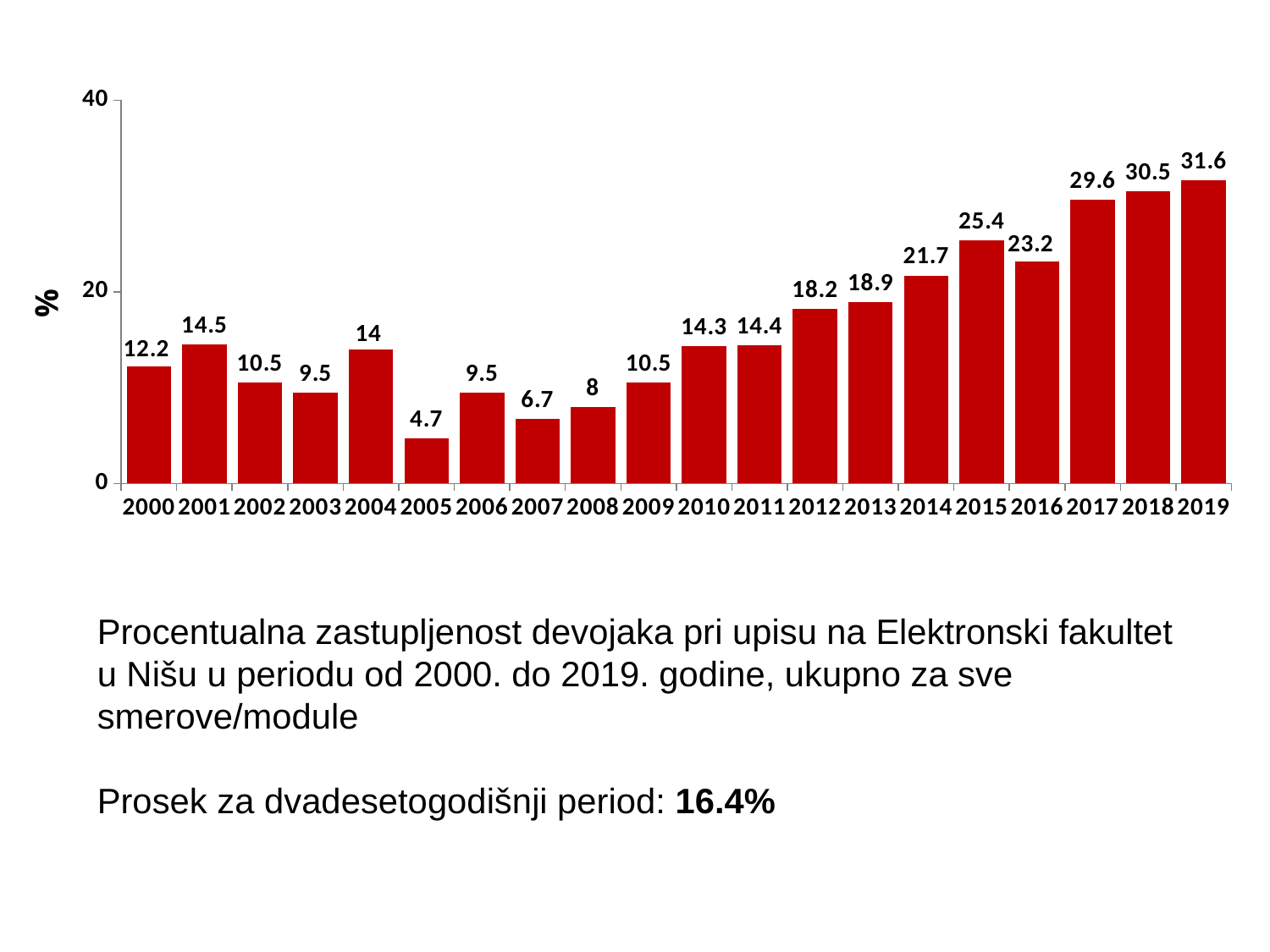
What is the value for 2012? 18.2 What kind of chart is this? bar chart Do the values generally rise or fall from 2009 to 2019? rise Which year has the highest value? 2019 Is the value for 2017 greater or less than 20? greater Which year has the lowest value? 2005 What is the value for 2005? 4.7 Which is larger, the value for 2015 or the value for 2016? 2015 What is the value for 2019? 31.6 How many years are shown on the x axis? 20 What is the difference between the values for 2019 and 2000? 19.4 What is the label on the y axis? %